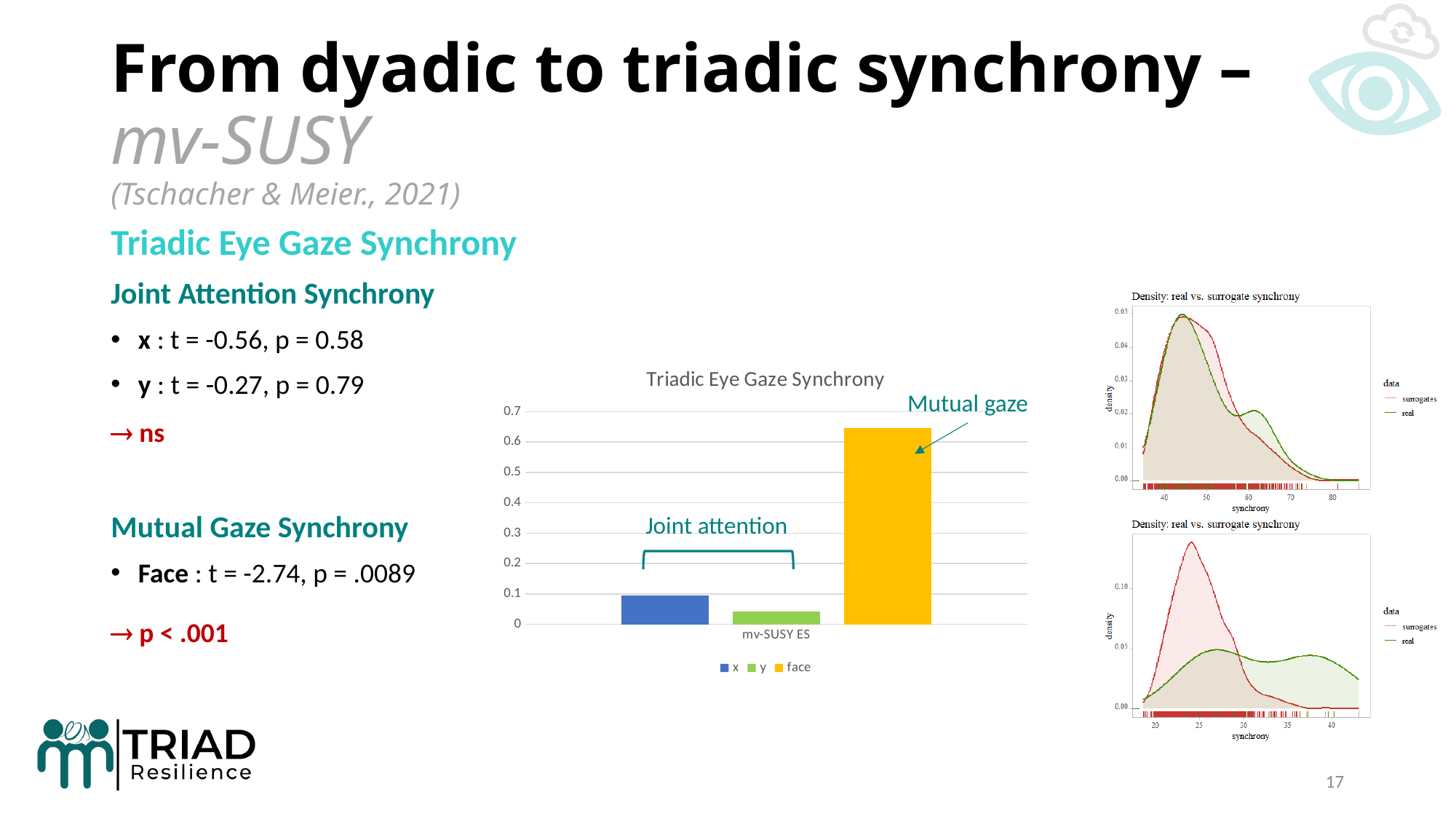
In the 'Triadic Eye Gaze Synchrony' bar chart, what colour is the bar for the 'face' series? yellow In the 'Triadic Eye Gaze Synchrony' bar chart, is the value for face greater or less than 0.7? less In the top density chart on the right of the slide, how many series does the legend list? 2 In the 'Triadic Eye Gaze Synchrony' bar chart, is the value for face greater or less than 0.6? greater What kind of chart is the 'Triadic Eye Gaze Synchrony' chart in the middle of the slide? bar chart In the 'Triadic Eye Gaze Synchrony' bar chart, which is larger, the value for x or the value for y? x In the 'Triadic Eye Gaze Synchrony' bar chart, what is the label of the category on the x axis? mv-SUSY ES In the 'Triadic Eye Gaze Synchrony' bar chart, is the value for y greater or less than 0.1? less In the 'Triadic Eye Gaze Synchrony' bar chart, how many series does the legend list? 3 In the 'Triadic Eye Gaze Synchrony' bar chart, which series has the lowest bar? y In the 'Triadic Eye Gaze Synchrony' bar chart, which series has the highest bar? face In the 'Triadic Eye Gaze Synchrony' bar chart, how many categories are shown on the x axis? 1